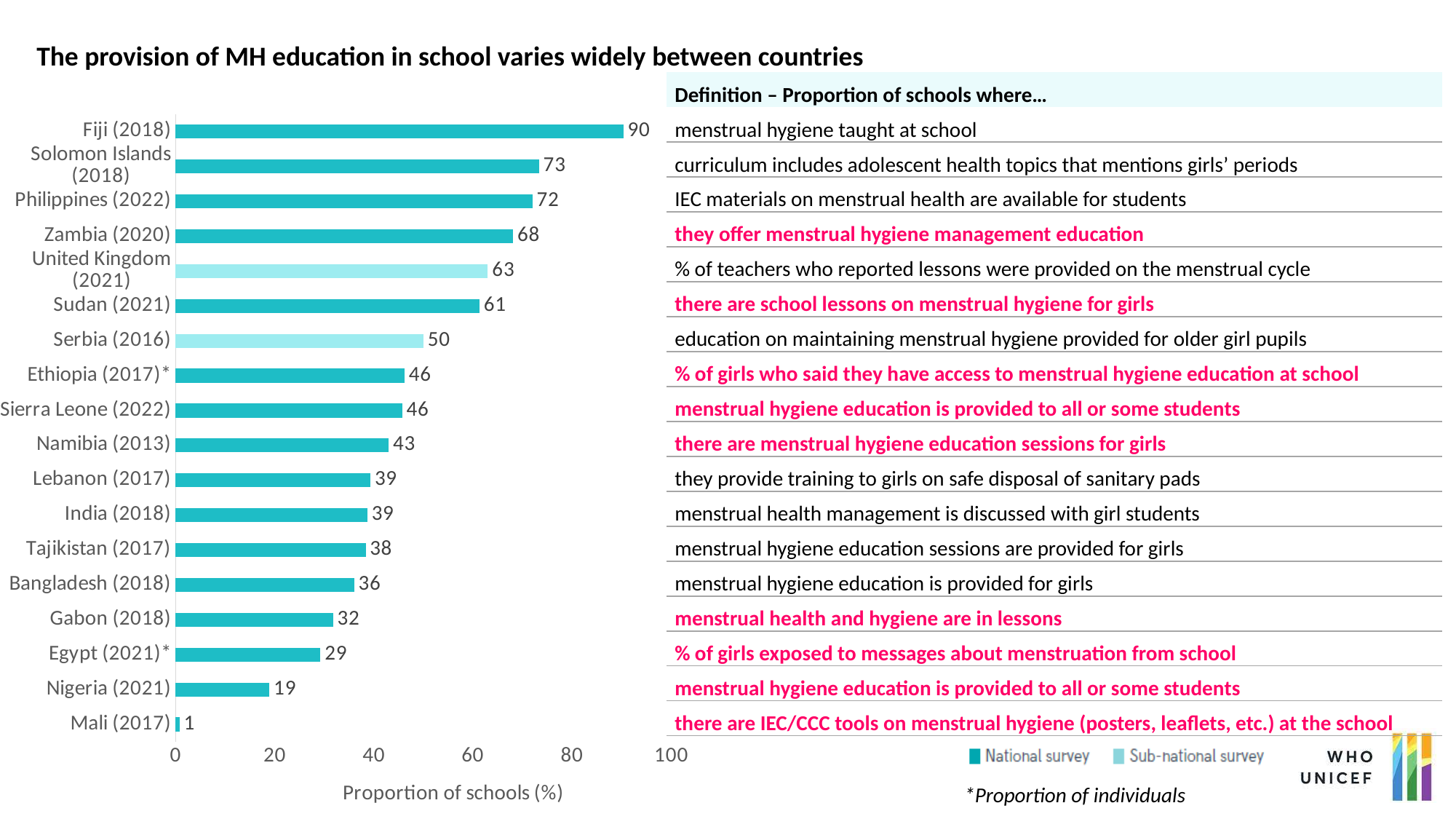
What kind of chart is shown on the slide? Bar chart Which is larger, the value for Sudan (2021) or the value for Serbia (2016)? Sudan (2021) Which two countries are shown as sub-national surveys (lighter bars)? United Kingdom (2021) and Serbia (2016) What is the value for Fiji (2018)? 90 Which country has the highest proportion of schools? Fiji (2018) What is the value for Zambia (2020)? 68 How many countries are shown in the chart? 18 How many series does the legend list? 2 Which country has the lowest proportion of schools? Mali (2017) What is the value for Nigeria (2021)? 19 What is the x-axis label of the chart? Proportion of schools (%) What is the difference between the values for Fiji (2018) and Solomon Islands (2018)? 17